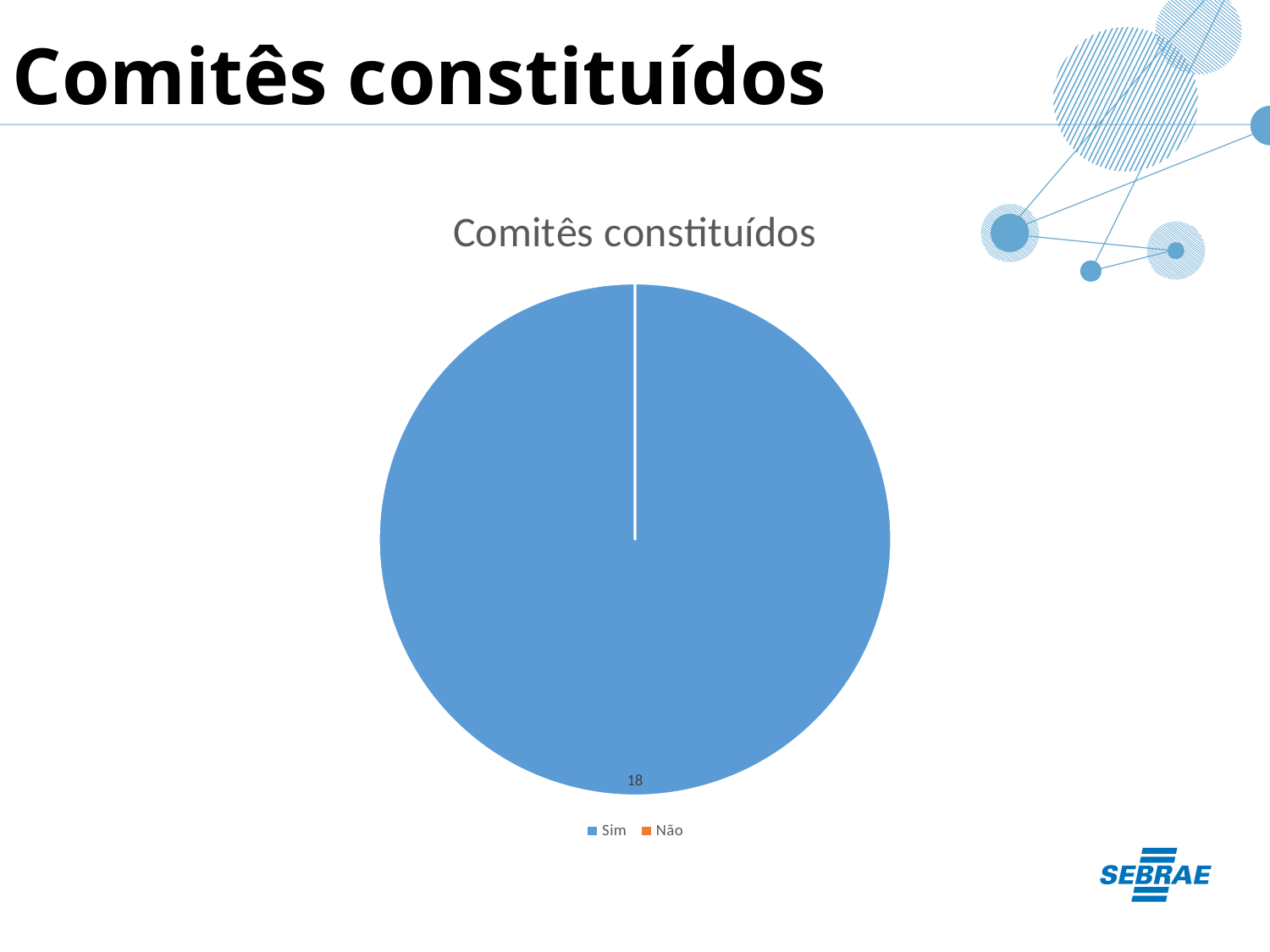
What value is shown for the "Sim" slice of the pie? 18 Which category has the largest slice of the pie? Sim Which is larger, the slice for "Sim" or the slice for "Não"? Sim Is the value for "Sim" greater or less than 10? greater What colour represents "Sim" in the legend? blue What is the title of the chart? Comitês constituídos What kind of chart is shown on the slide? pie chart How many entries does the chart's legend list? 2 Which category has the smallest share of the pie? Não